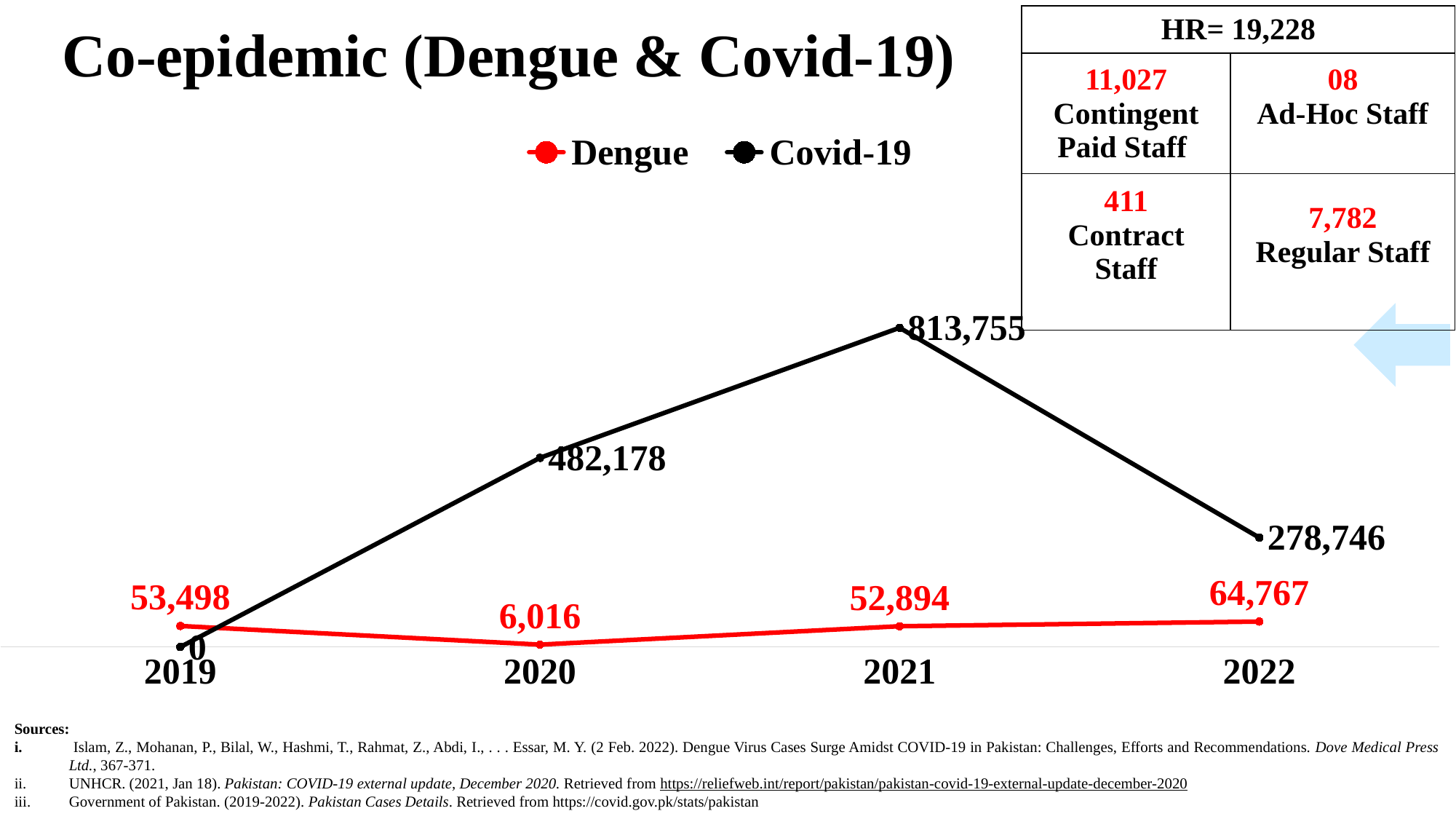
In which year is the Dengue series lowest? 2020 What is the Covid-19 value for 2022? 278,746 Which is larger in 2022, the Dengue value or the Covid-19 value? Covid-19 How many series does the legend list? 2 What is the Dengue value for 2019? 53,498 Does the Dengue series rise or fall from 2020 to 2022? Rise In which year is the Covid-19 series highest? 2021 How many years are shown on the x axis? 4 What is the Dengue value for 2020? 6,016 What is the Covid-19 value for 2021? 813,755 What kind of chart is shown? Line chart What is the difference between the Covid-19 values for 2021 and 2020? 331,577